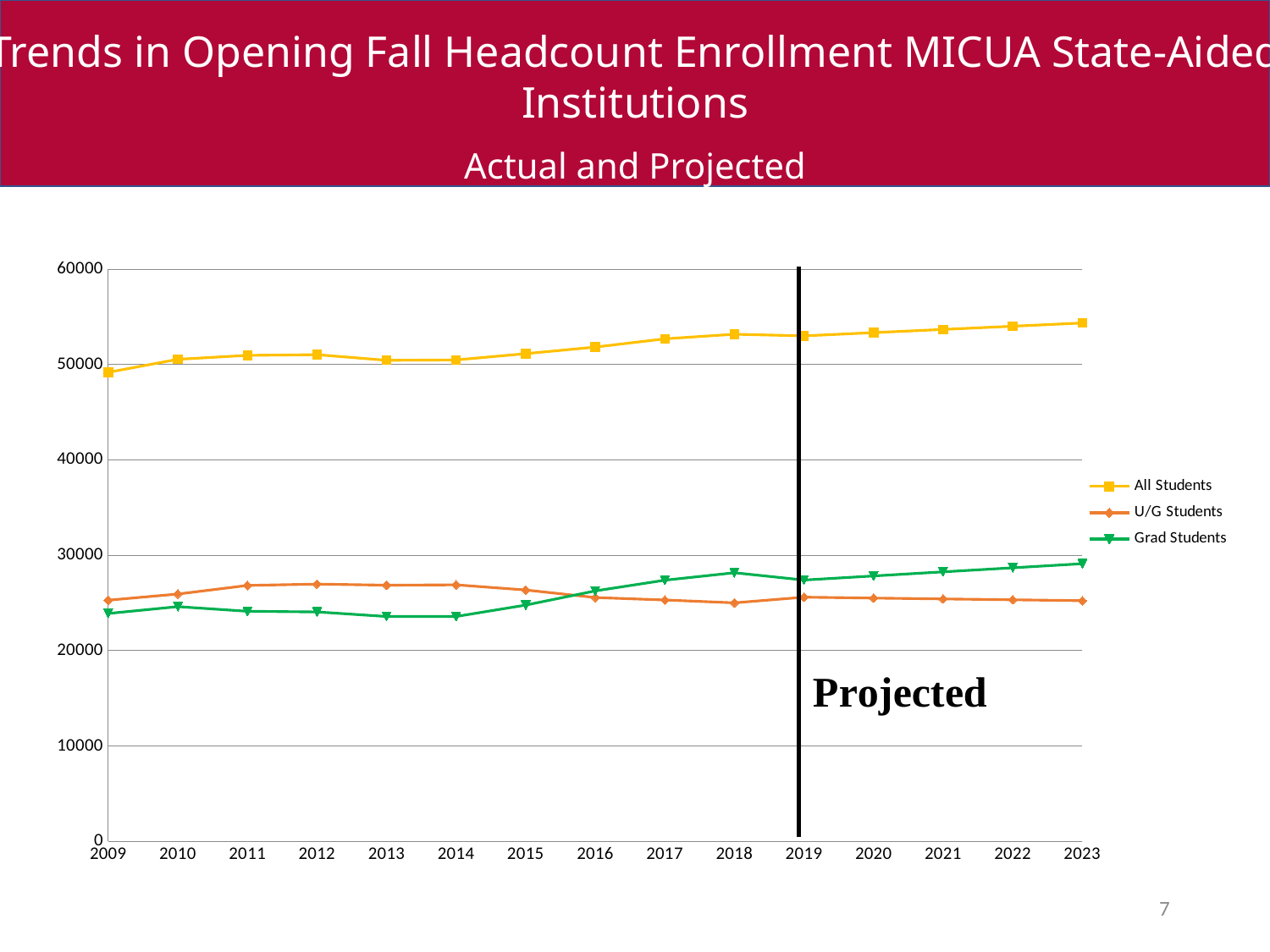
Is the value for Grad Students in 2023 greater or less than 30000? less What kind of chart is shown on the slide? Line chart Is the value for All Students in 2023 greater or less than 50000? greater How many years are plotted along the x axis? 15 In 2018, which is larger: U/G Students or Grad Students? Grad Students Is the value for All Students in 2009 greater or less than 50000? less What word is written next to the vertical black line at 2019? Projected In which year is the All Students line at its lowest? 2009 In which year is the All Students line at its highest? 2023 How many series does the legend list? 3 Which series has the highest values across all years? All Students Do the All Students values rise or fall from 2019 to 2023? Rise